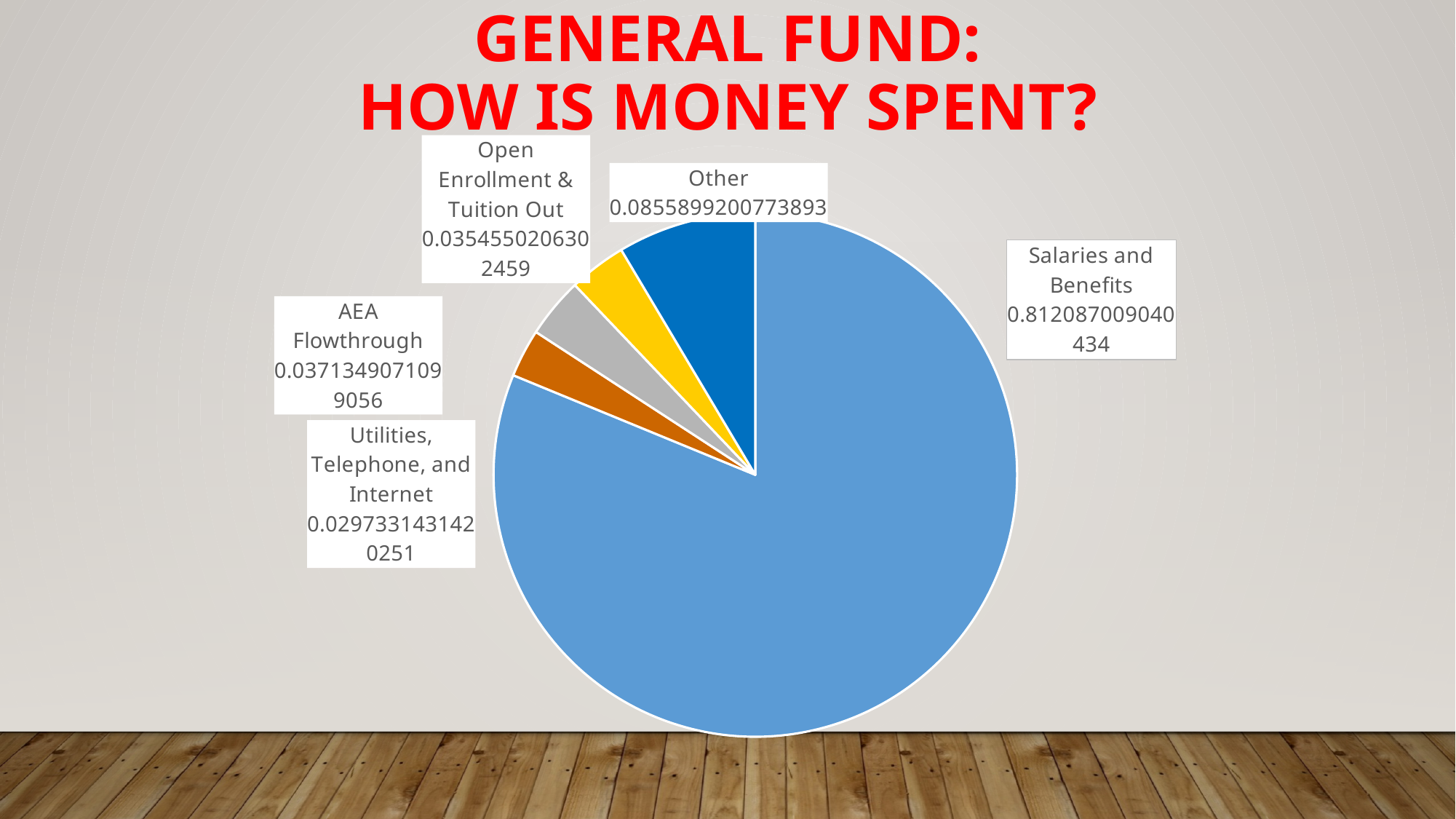
Which category has the largest slice of the pie? Salaries and Benefits Which is larger, the value for Other or the value for Open Enrollment & Tuition Out? Other What is the value shown for AEA Flowthrough? 0.0371349071099056 How many slices does the pie chart have? 5 What kind of chart is shown on the slide? pie chart What is the value shown for Salaries and Benefits? 0.812087009040434 Which category has the smallest slice of the pie? Utilities, Telephone, and Internet What is the value shown for Other? 0.0855899200773893 What colour is the Salaries and Benefits slice? light blue What is the value shown for Open Enrollment & Tuition Out? 0.0354550206302459 What is the value shown for Utilities, Telephone, and Internet? 0.0297331431420251 What is the title of the slide containing the chart? General Fund: How is Money Spent?